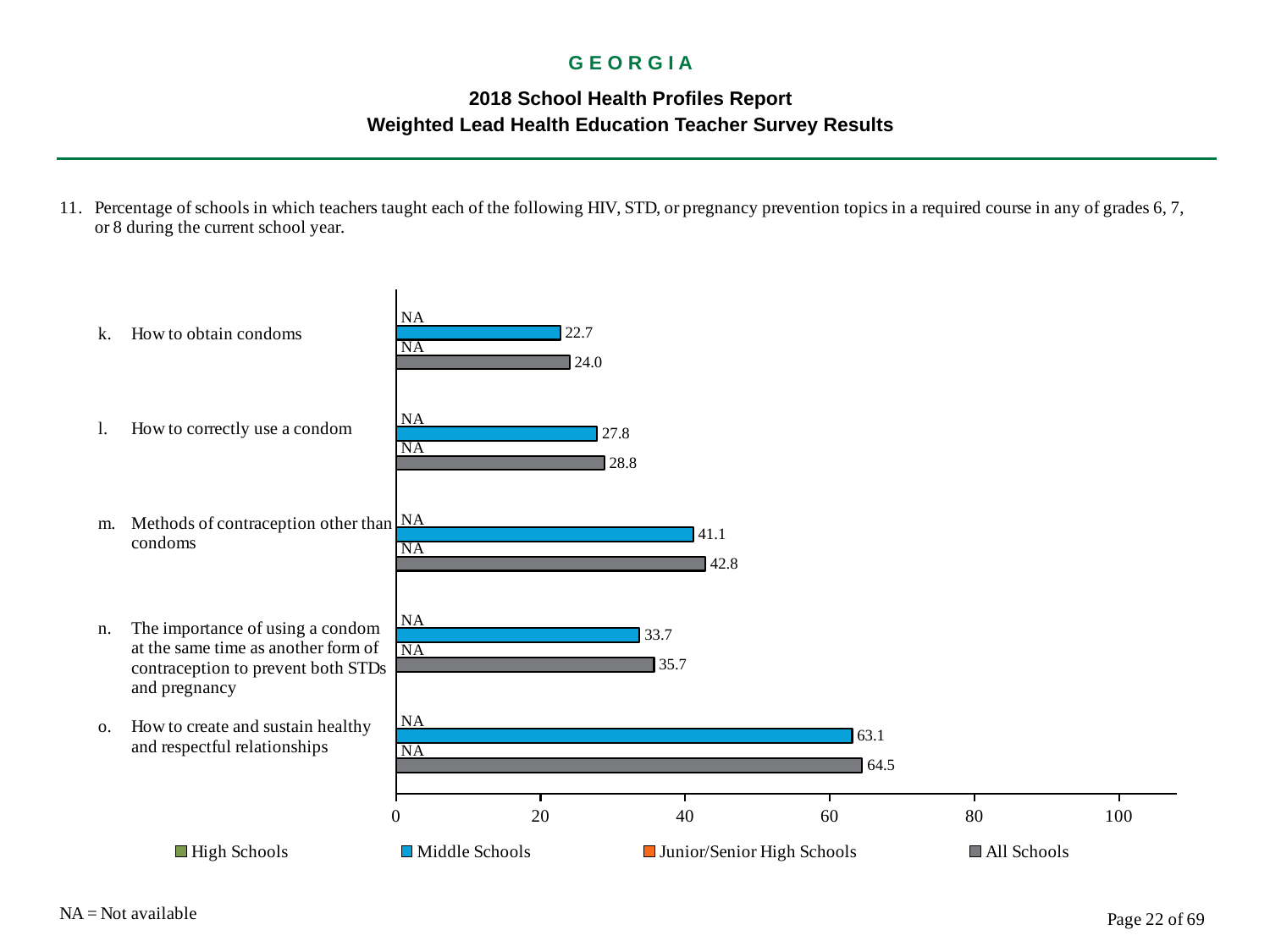
Is the All Schools value for 'How to create and sustain healthy and respectful relationships' greater or less than 60? greater What kind of chart is shown on the slide? bar chart What is the difference between the All Schools and Middle Schools values for 'How to correctly use a condom'? 1.0 Which is larger for 'Methods of contraception other than condoms': the Middle Schools value or the All Schools value? All Schools What is the Middle Schools value for 'The importance of using a condom at the same time as another form of contraception to prevent both STDs and pregnancy'? 33.7 What is the All Schools value for 'Methods of contraception other than condoms'? 42.8 What is the Middle Schools value for 'How to obtain condoms'? 22.7 Which topic has the highest Middle Schools value? How to create and sustain healthy and respectful relationships Which topic has the lowest All Schools value? How to obtain condoms How many series does the legend list? 4 How many topics are listed on the chart? 5 What is the All Schools value for 'How to create and sustain healthy and respectful relationships'? 64.5